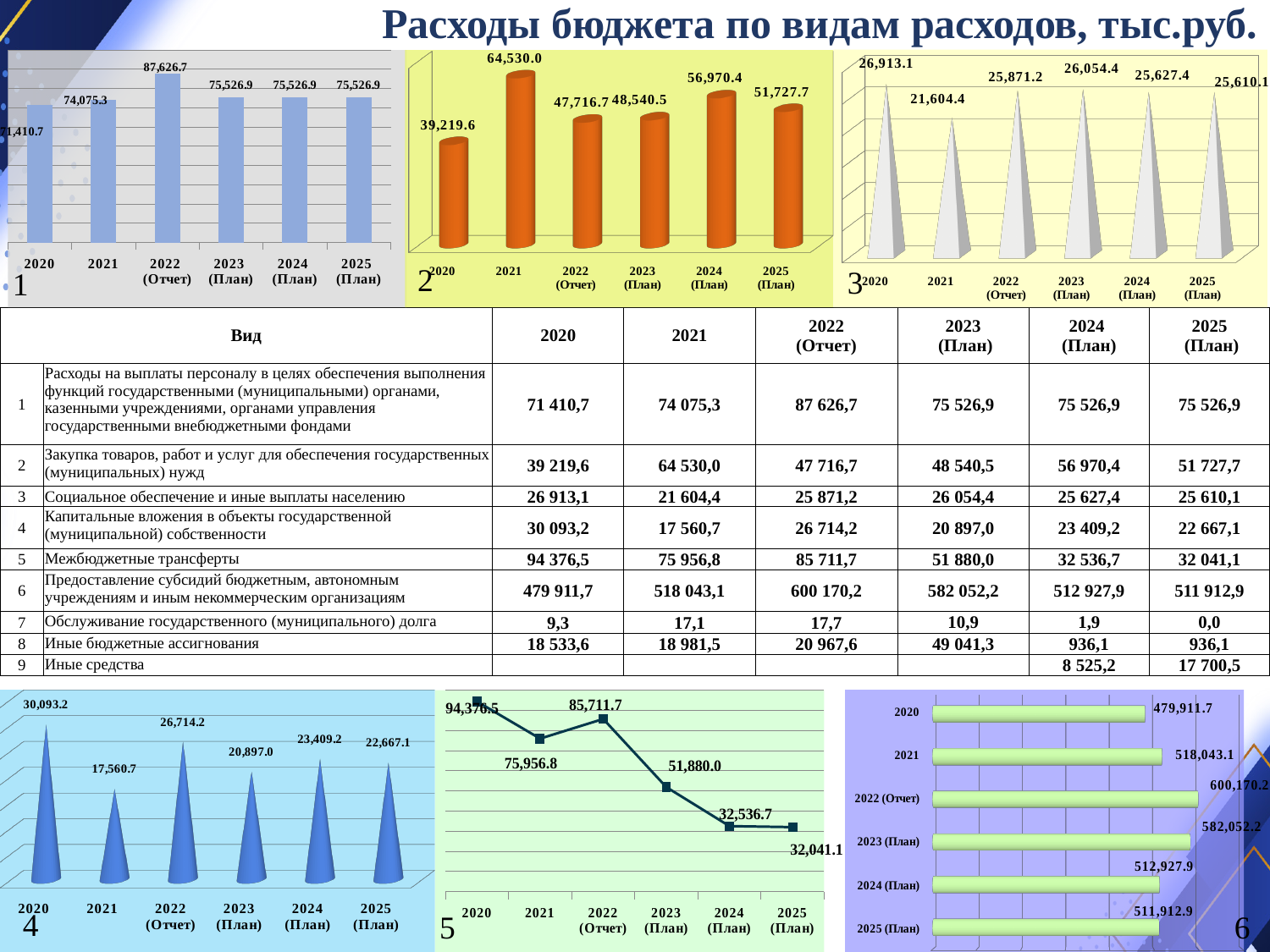
In chart 4 (bottom left), which year has the highest value? 2020 In chart 5 (bottom middle), do the values generally rise or fall from 2020 to 2025? Fall What kind of chart is chart 5 (bottom middle)? Line chart In chart 2 (top middle), what is the difference between the 2024 (План) and 2023 (План) values? 8,429.9 In chart 3 (top right), what is the value for 2021? 21,604.4 In chart 2 (top middle), what is the value for 2021? 64,530.0 In chart 1 (top left), what is the value for 2022 (Отчет)? 87,626.7 In chart 6 (bottom right), which year has the highest value? 2022 (Отчет) In chart 4 (bottom left), what is the value for 2023 (План)? 20,897.0 In chart 6 (bottom right), is the value for 2021 larger or smaller than the value for 2024 (План)? Larger In chart 2 (top middle), which year has the lowest value? 2020 In chart 1 (top left), which year has the highest value? 2022 (Отчет)